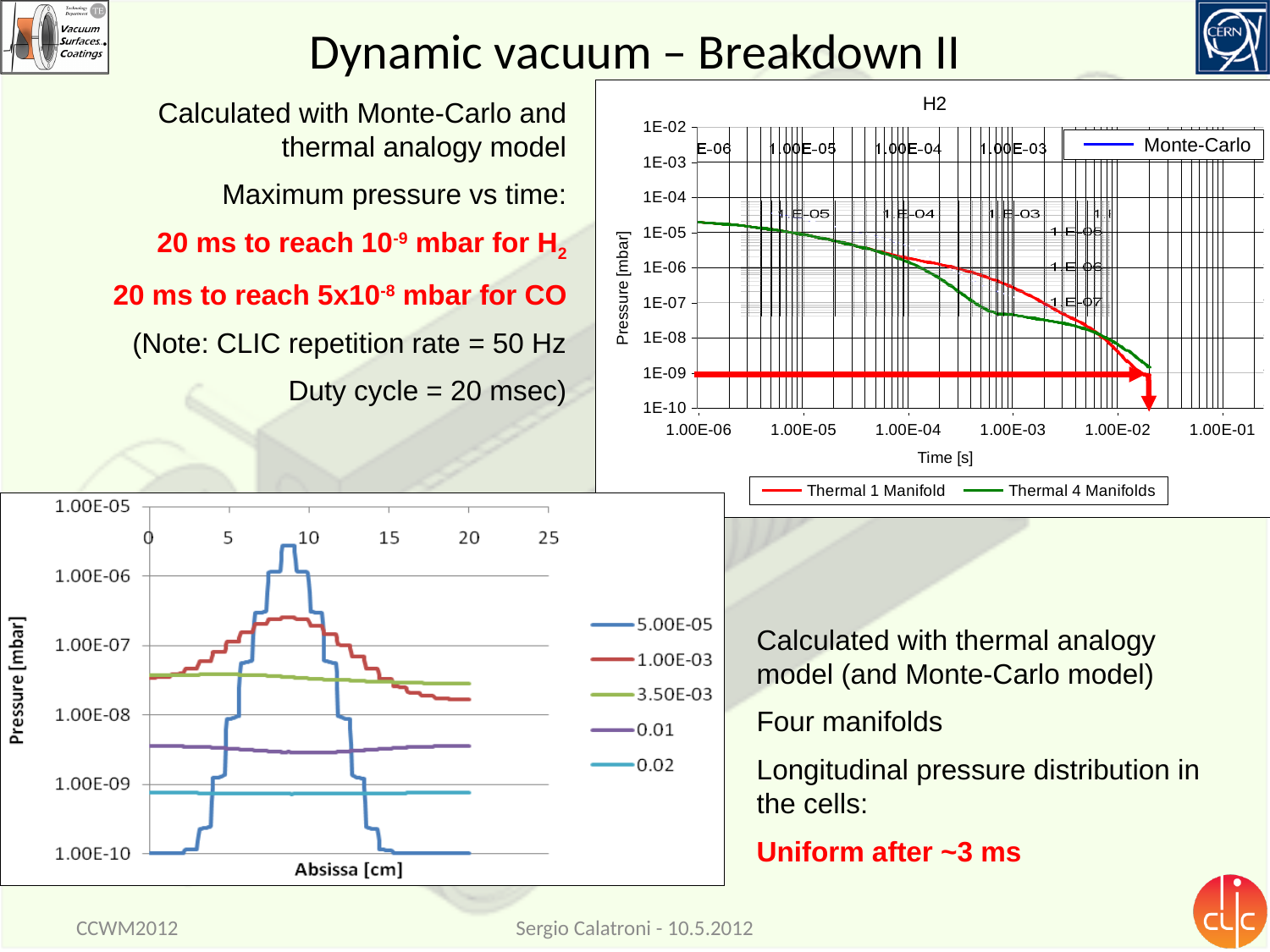
What kind of chart is the H2 chart at the top right of the slide? line chart How many series does the legend of the bottom-left chart list? 5 What is the title of the chart at the top right of the slide? H2 In the H2 chart, is the Thermal 1 Manifold value at 1.00E-04 s greater or less than 1E-06 mbar? greater In the H2 chart, which series is higher at 1.00E-03 s, Thermal 1 Manifold or Thermal 4 Manifolds? Thermal 1 Manifold In the bottom-left chart, is the value of the 0.02 series greater or less than 1.00E-09 mbar? less What is the x-axis label of the bottom-left chart? Absissa [cm] In the H2 chart, does the pressure rise or fall as time increases along the x axis? fall In the bottom-left chart, which series reaches the highest pressure? 5.00E-05 In the H2 chart, is the Thermal 4 Manifolds value at 1.00E-03 s greater or less than 1E-07 mbar? less In the bottom-left chart, which series is higher at abscissa 10 cm, 1.00E-03 or 3.50E-03? 1.00E-03 In the bottom-left chart, which series has the lowest pressure across the cell? 0.02